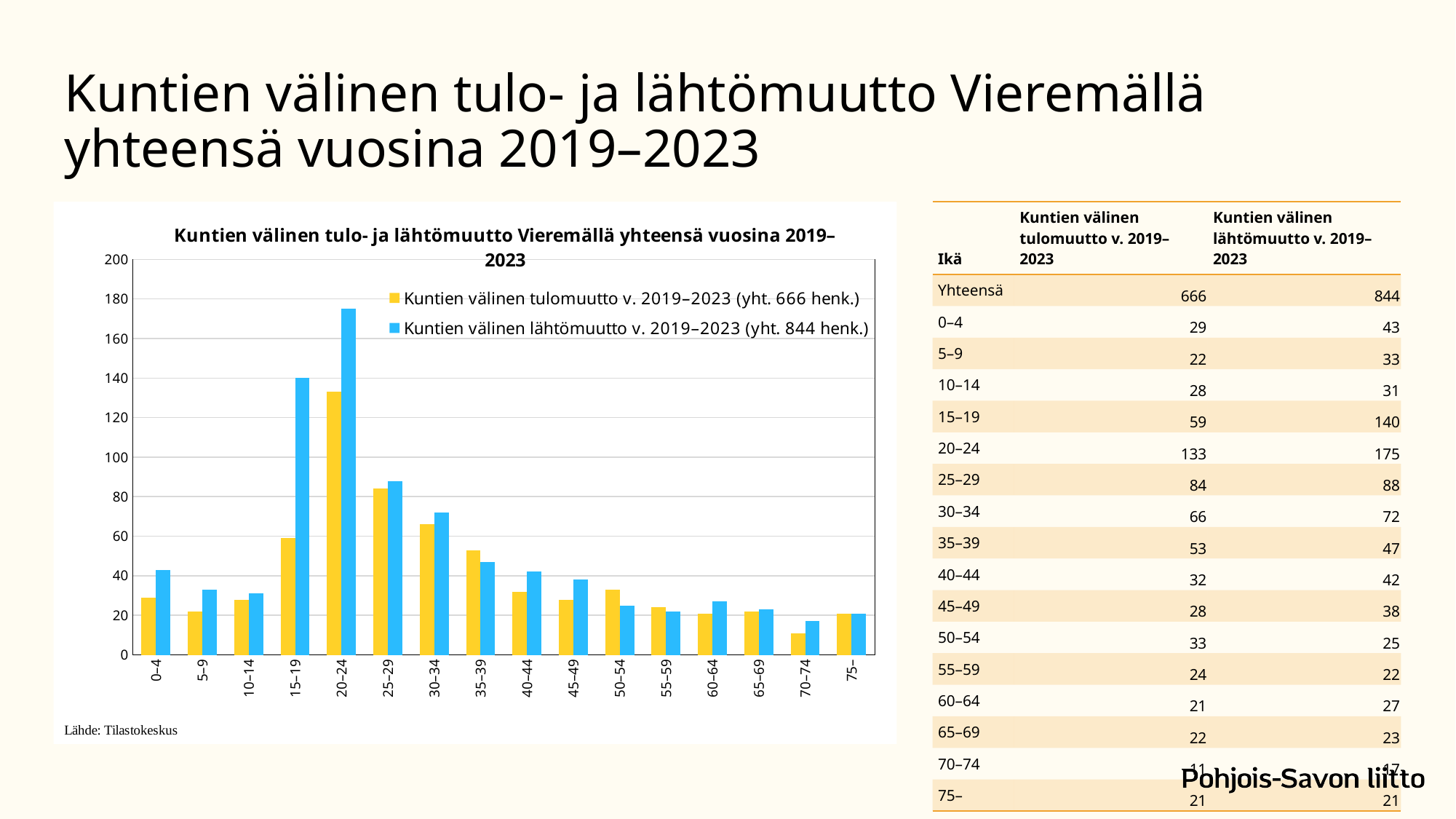
Which age group has the lowest value for Kuntien välinen tulomuutto v. 2019–2023? 70–74 What kind of chart is shown on the slide? bar chart Is the value of lähtömuutto for the 15–19 age group greater or less than 120? greater How many series does the chart's legend list? 2 What is the value of Kuntien välinen lähtömuutto v. 2019–2023 for the 15–19 age group? 140 What is the value of Kuntien välinen tulomuutto v. 2019–2023 for the 20–24 age group? 133 For the 20–24 age group, what is the difference between lähtömuutto and tulomuutto? 42 Is the value of tulomuutto for the 70–74 age group greater or less than 20? less Which age group has the highest value for Kuntien välinen lähtömuutto v. 2019–2023? 20–24 According to the legend, what is the total number of persons for Kuntien välinen tulomuutto v. 2019–2023? 666 henk. For the 35–39 age group, which is larger: tulomuutto or lähtömuutto? tulomuutto How many age groups are shown on the x axis of the chart? 16